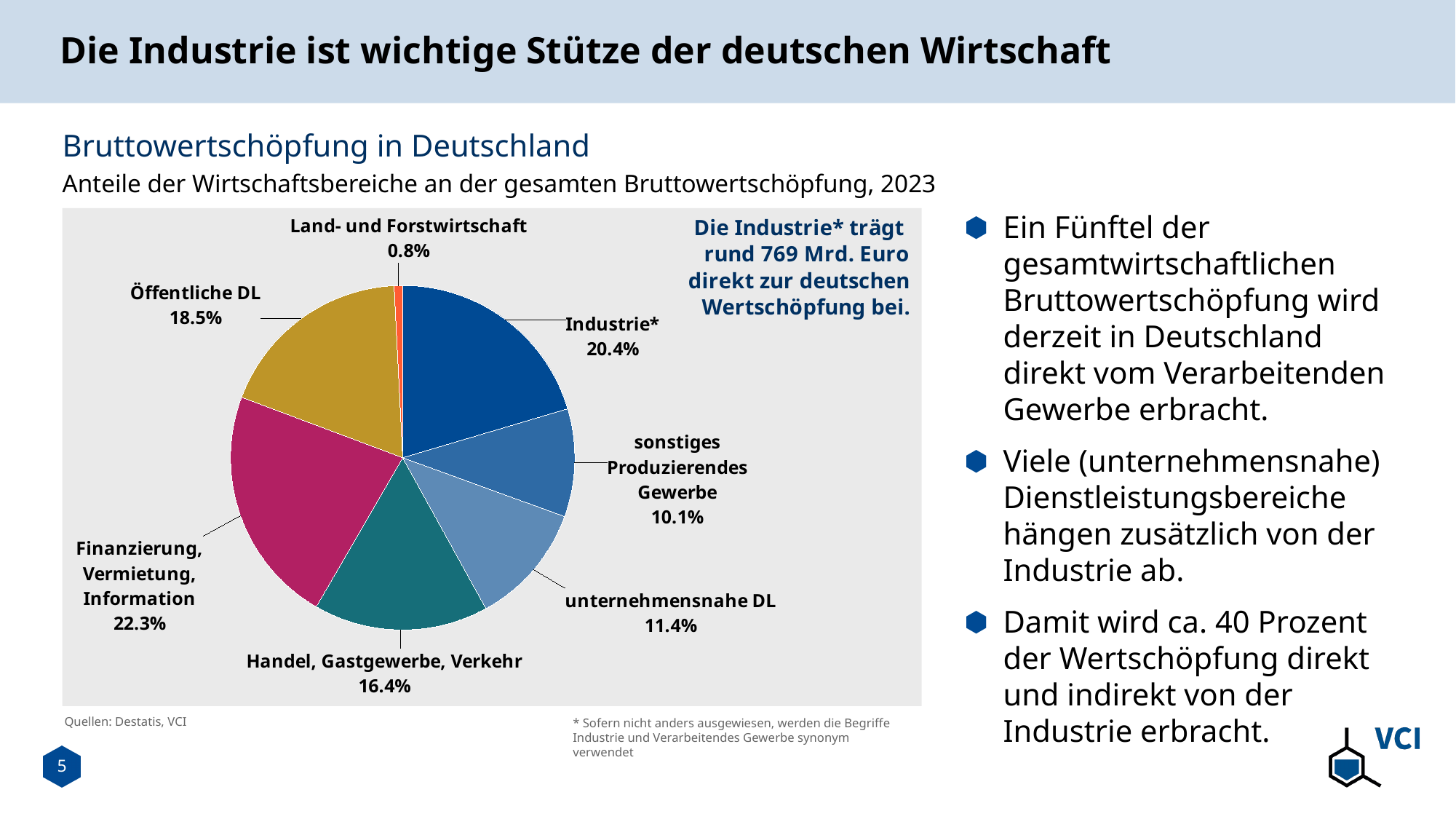
Which sector has the smallest share in the pie chart? Land- und Forstwirtschaft What is the combined share of Industrie* and sonstiges Produzierendes Gewerbe? 30.5% How many slices does the pie chart have? 7 What is the difference in percentage points between Industrie* and sonstiges Produzierendes Gewerbe? 10.3 percentage points Which sector has the largest share in the pie chart? Finanzierung, Vermietung, Information What is the share shown for Öffentliche DL? 18.5% What is the share shown for Handel, Gastgewerbe, Verkehr? 16.4% What is the title of the chart? Bruttowertschöpfung in Deutschland What is the share shown for Land- und Forstwirtschaft? 0.8% What share of gross value added does Industrie* have in the pie chart? 20.4% Which has a larger share: unternehmensnahe DL or sonstiges Produzierendes Gewerbe? unternehmensnahe DL What kind of chart is shown on the slide? Pie chart